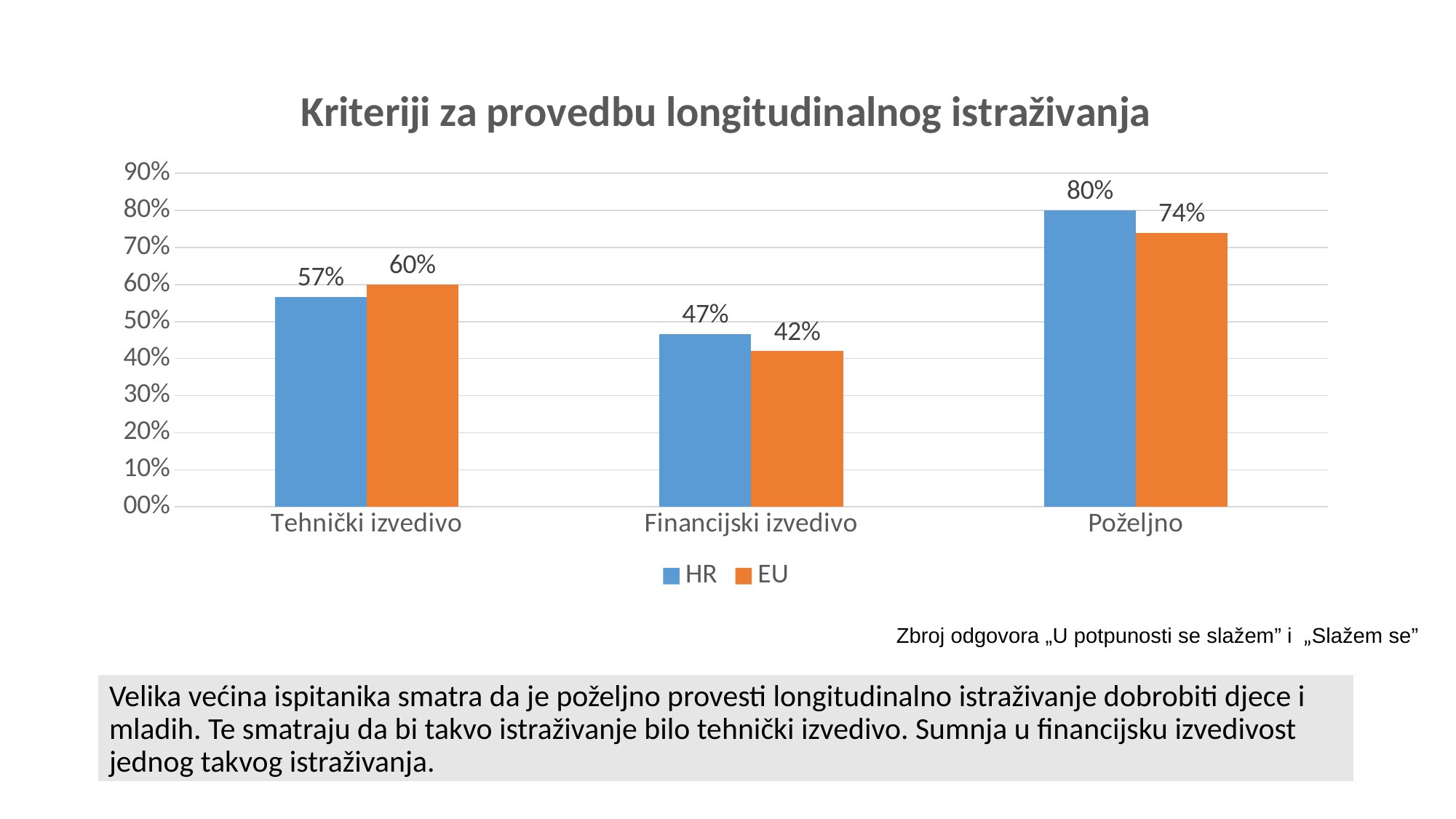
What kind of chart is shown on the slide? bar chart What is the EU value for Poželjno? 74% For Tehnički izvedivo, which is larger, the HR value or the EU value? EU What is the difference between the HR and EU values for Poželjno? 6% How many series does the legend list? 2 What is the HR value for Tehnički izvedivo? 57% What is the title of the chart? Kriteriji za provedbu longitudinalnog istraživanja What is the EU value for Financijski izvedivo? 42% Is the HR value for Financijski izvedivo greater or less than 50%? less Which category has the highest HR value? Poželjno How many categories are shown on the x axis? 3 Which category has the lowest EU value? Financijski izvedivo